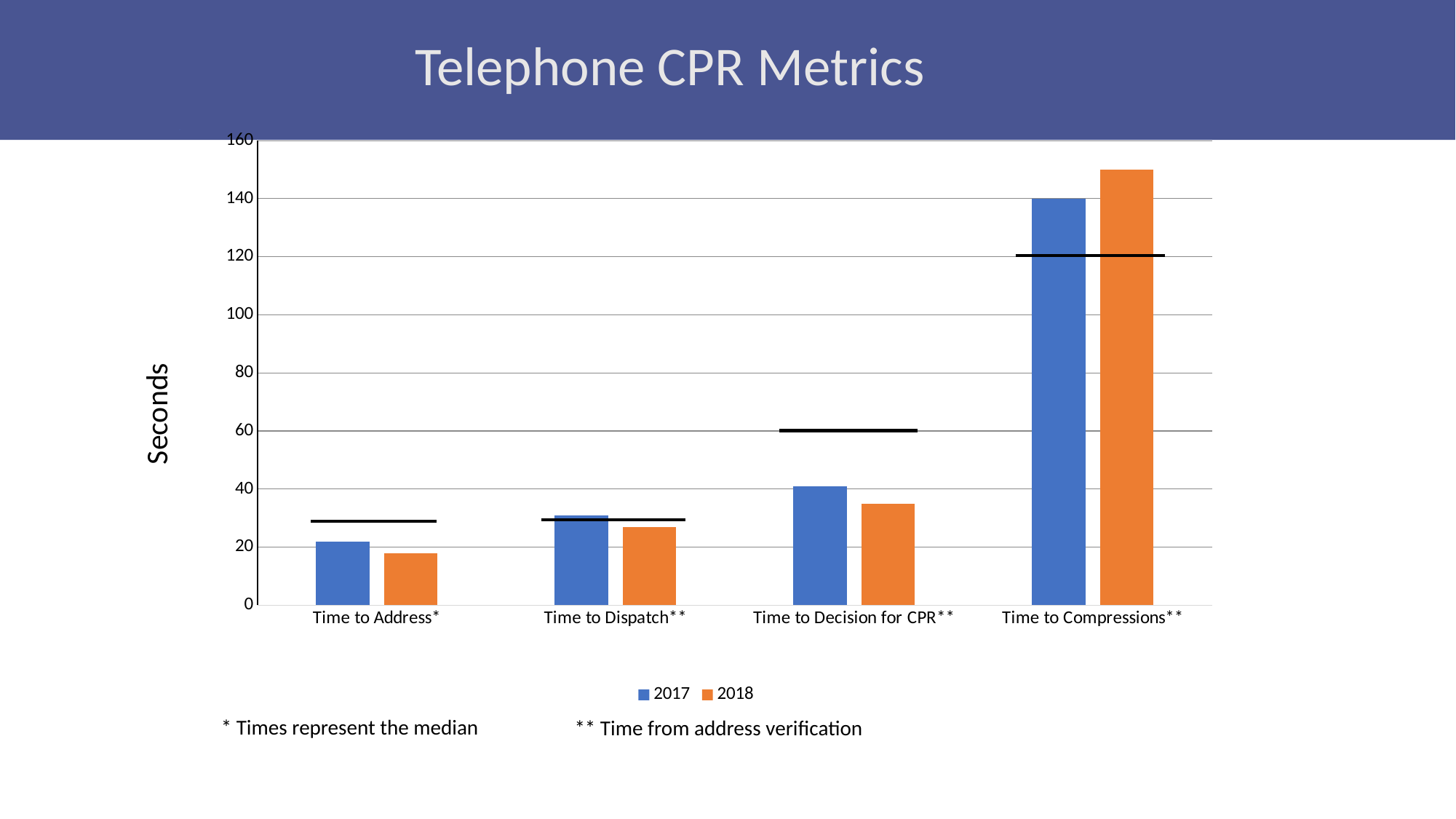
Which category has the lowest values in the chart? Time to Address* Is the 2017 value for Time to Decision for CPR** greater or less than 60? less Which category has the highest values in the chart? Time to Compressions** Is the 2018 value for Time to Address* greater or less than 20? less What kind of chart is shown on the slide? bar chart Which colour represents the 2018 series in the chart? orange For Time to Decision for CPR**, which year has the larger value, 2017 or 2018? 2017 Is the 2018 value for Time to Compressions** greater or less than 140? greater For Time to Compressions**, which year has the larger value, 2017 or 2018? 2018 How many categories are shown on the x axis of the chart? 4 What is the label of the vertical axis? Seconds How many series does the legend list? 2